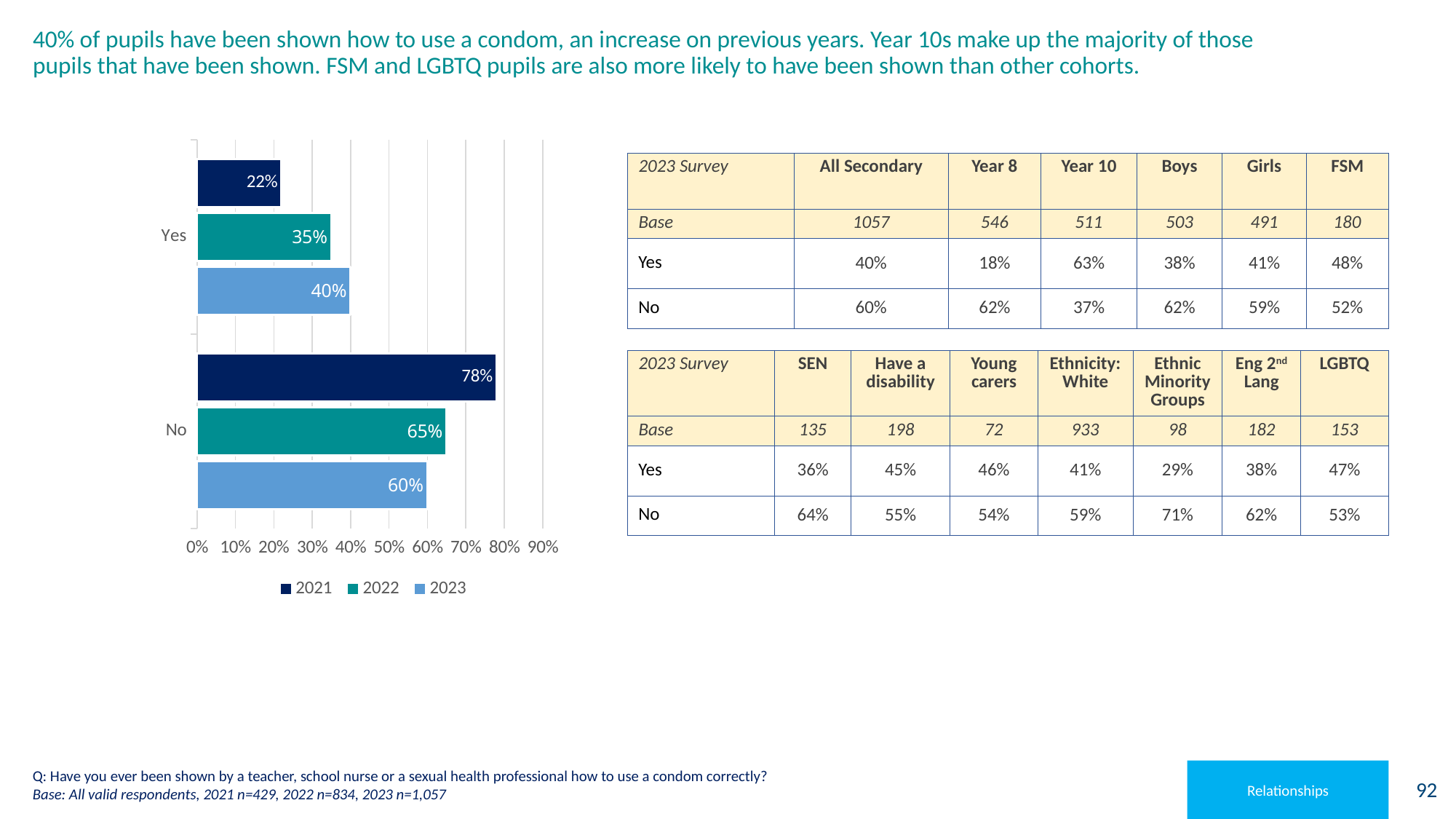
Which year has the lowest value for 'No'? 2023 What is the value for 'No' in the 2023 series? 60% Which year has the highest value for 'Yes'? 2023 Is the 2021 value for 'No' greater or less than 70%? greater What is the value for 'Yes' in the 2023 series? 40% What kind of chart is shown on the slide? Bar chart What is the value for 'No' in the 2021 series? 78% Which is larger: the 2022 value for 'No' or the 2023 value for 'No'? 2022 What is the value for 'Yes' in the 2022 series? 35% What is the difference between the 2023 and 2021 values for 'Yes'? 18% Do the values for 'Yes' rise or fall from 2021 to 2023? Rise How many series does the legend list? 3